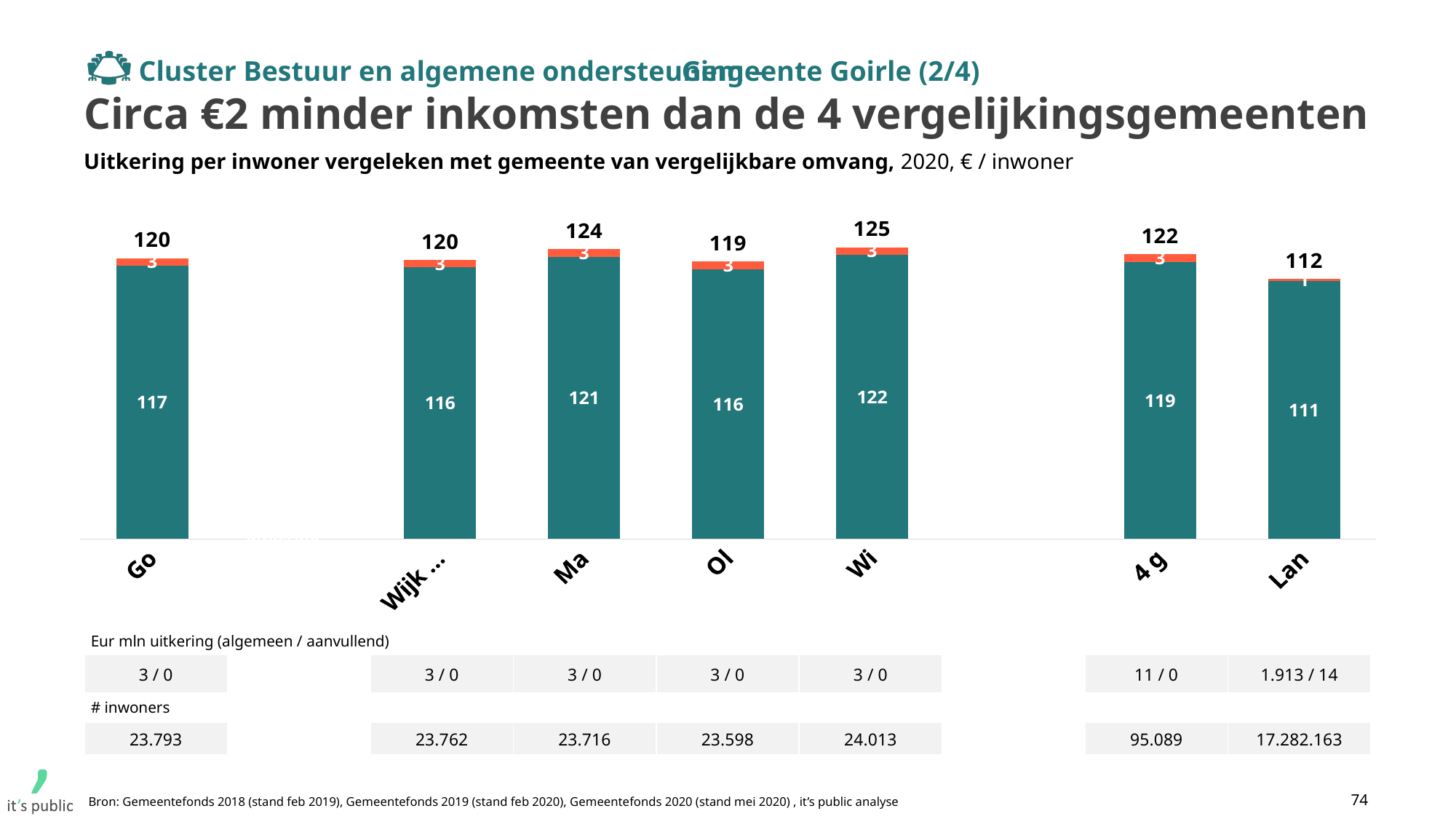
What is the number of inhabitants (# inwoners) listed under the Go bar? 23.793 What is the total value shown above the bar for Go? 120 What is the value of the teal (lower) segment for Lan? 111 Which category has the lowest total value? Lan What is the difference between the total for Wi and the total for Lan? 13 What is the difference between the teal segment for Ma and the teal segment for Ol? 5 How many bars are shown in the chart? 7 What is the value of the teal (lower) segment for Wi? 122 Which has a larger total value, Ma or 4 g? Ma What is the value of the orange (upper) segment for Ma? 3 What kind of chart is shown on the slide? Stacked bar chart Which category has the highest total value? Wi